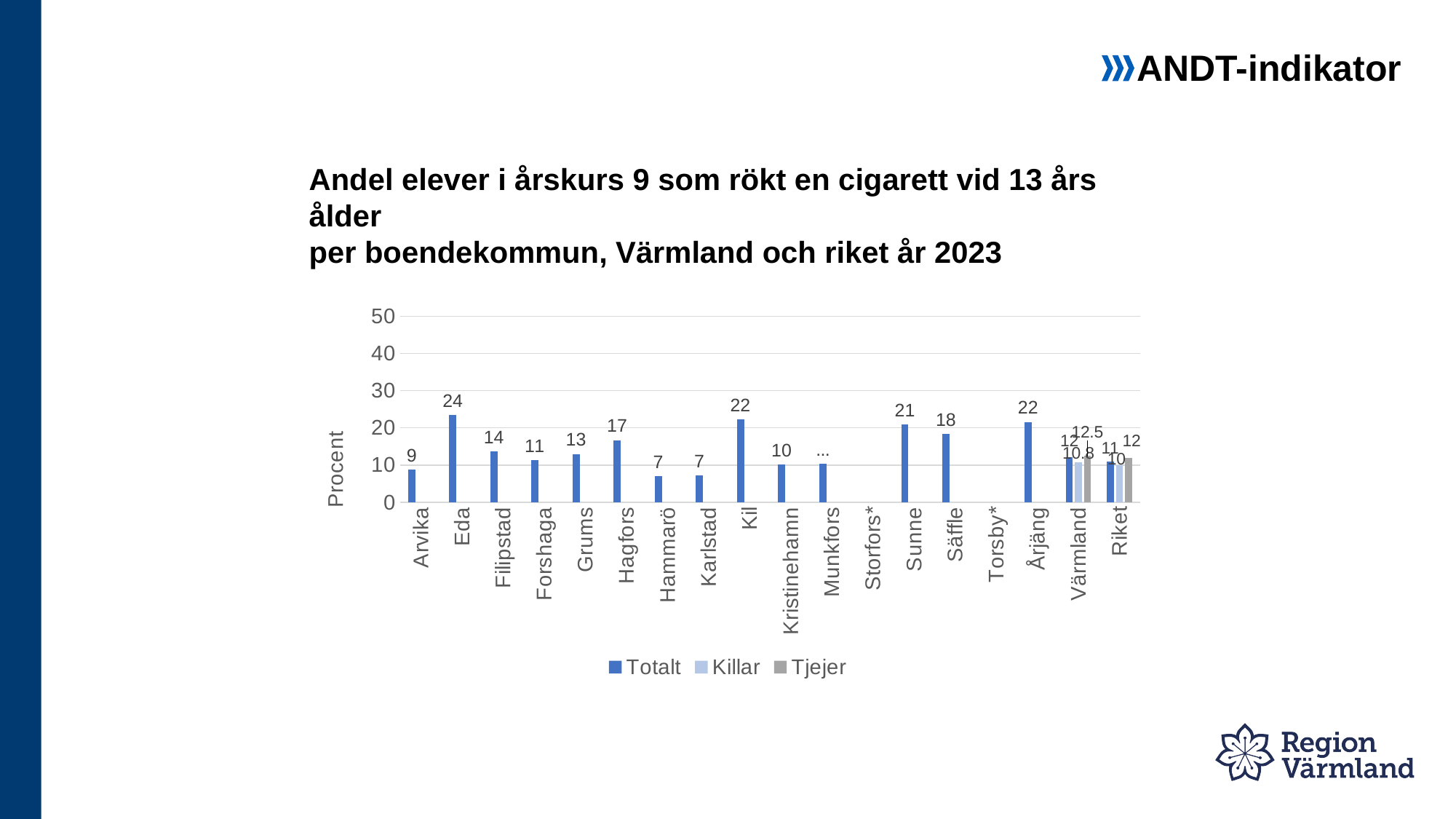
What is the difference between the Totalt values for Eda and Arvika? 15 What kind of chart is shown on the slide? bar chart How many series does the legend list? 3 What is the Totalt value for Eda? 24 What is the Tjejer value for Värmland? 12.5 What is the Killar value for Riket? 10 Which municipality has the highest Totalt value? Eda What is the label on the y axis? Procent Which has a higher Totalt value, Sunne or Säffle? Sunne How many categories are shown on the x axis? 18 Is the Totalt value for Munkfors greater or less than 20? less What is the Totalt value for Hagfors? 17